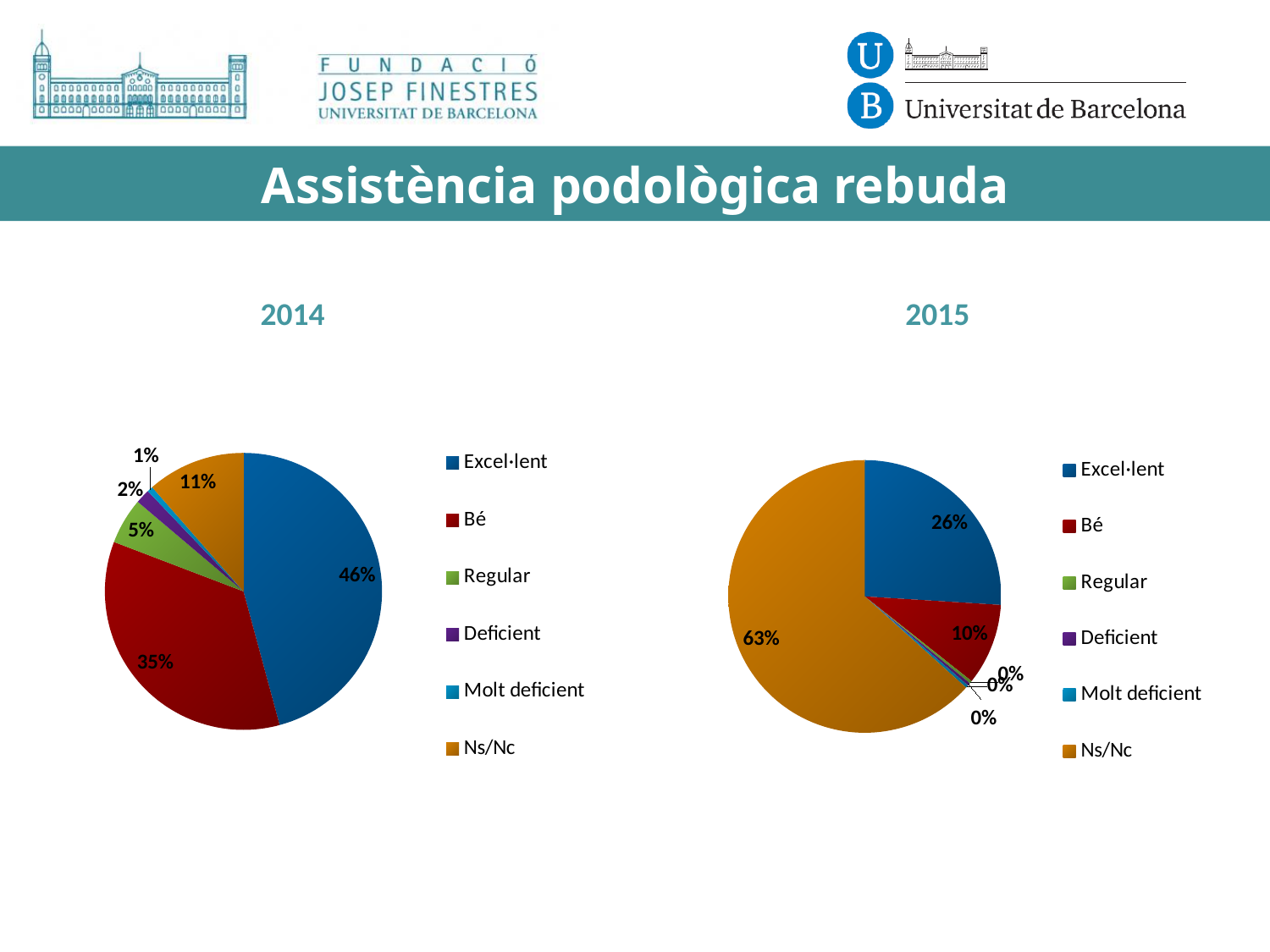
In the 2015 chart, what percentage is shown for Excel·lent? 26% In the 2014 chart, what percentage is shown for Ns/Nc? 11% In the 2015 chart, which is larger, Excel·lent or Bé? Excel·lent In the 2014 chart, which category has the smallest slice? Molt deficient In the 2014 chart, what is the difference between the Excel·lent and Bé percentages? 11% In the 2014 chart, which category has the largest slice? Excel·lent In the 2014 chart, what percentage is shown for Bé? 35% In the 2014 chart, what share of the pie is Excel·lent? 46% In the 2015 chart, what percentage is shown for Bé? 10% In the 2015 chart, what share of the pie is Ns/Nc? 63% In the 2015 chart, which category has the largest slice? Ns/Nc How many categories does the legend of the 2014 chart list? 6